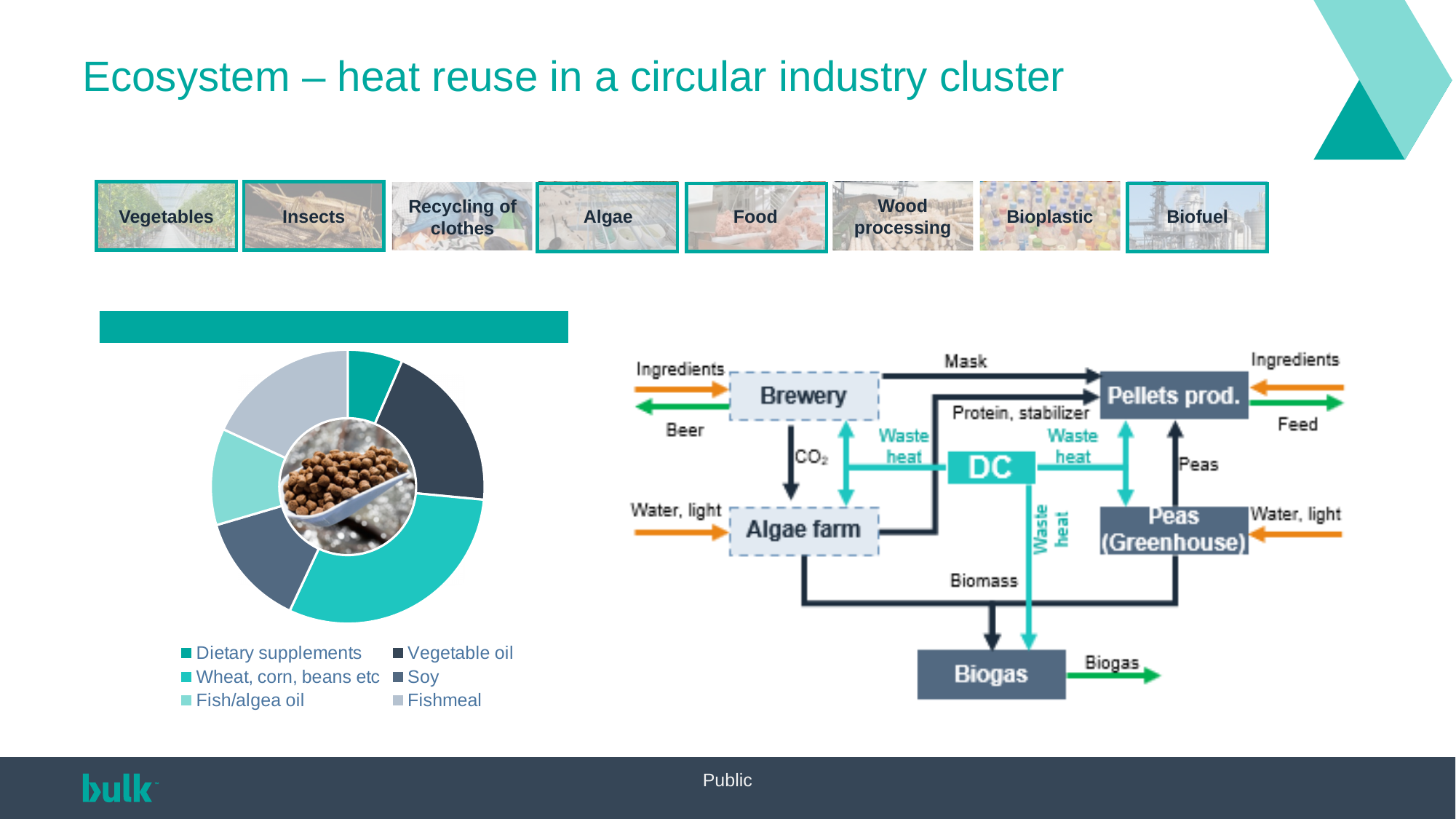
In the pie chart, which slice is larger: Fishmeal or Fish/algea oil? Fishmeal In the pie chart, which slice is larger: Wheat, corn, beans etc or Fishmeal? Wheat, corn, beans etc Which legend entry of the pie chart is shown in the darkest colour? Vegetable oil In the pie chart, which slice is larger: Vegetable oil or Soy? Vegetable oil How many slices does the pie chart on the left have? 6 Which category has the largest slice in the pie chart? Wheat, corn, beans etc What kind of chart is shown on the left side of the slide? Pie chart (doughnut) How many entries does the legend of the pie chart list? 6 Which category has the smallest slice in the pie chart? Dietary supplements Which legend entry of the pie chart is shown in the lightest grey colour? Fishmeal